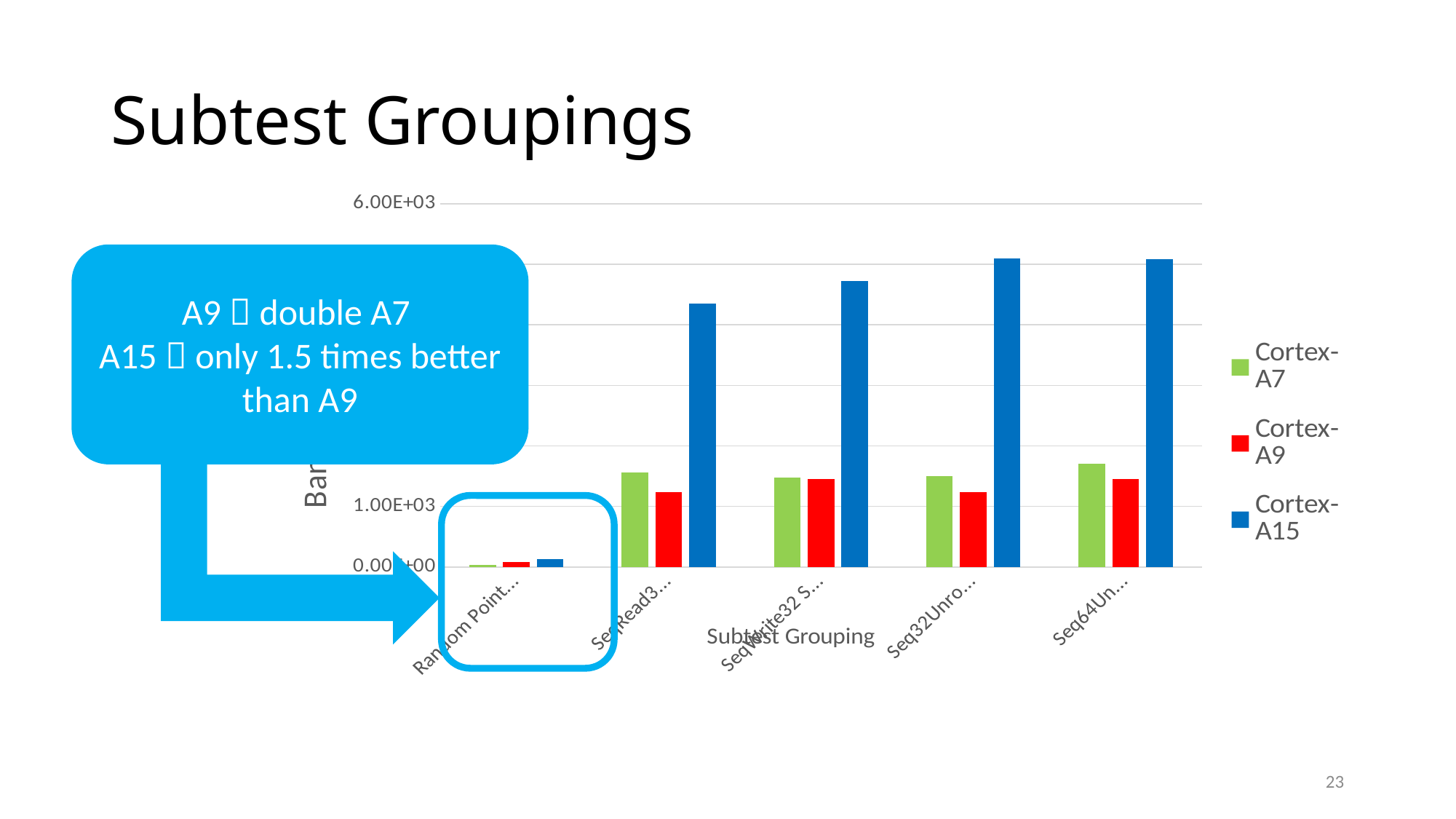
Which category has the lowest Cortex-A15 value? Random Point... Which series does the legend list with the blue colour? Cortex-A15 How many subtest grouping categories are plotted along the x axis? 5 Is the Cortex-A9 value for Seq32Unro... greater or less than 2.00E+03? less For SeqRead3..., which is larger: the Cortex-A7 value or the Cortex-A9 value? Cortex-A7 How many series does the legend list? 3 What kind of chart is shown on the slide? bar chart Which series has the highest value for Seq64Un...? Cortex-A15 Is the Cortex-A15 value for SeqRead3... greater or less than 5.00E+03? less Is the Cortex-A7 value for Random Point... greater or less than 1.00E+03? less What is the title of the x axis? Subtest Grouping